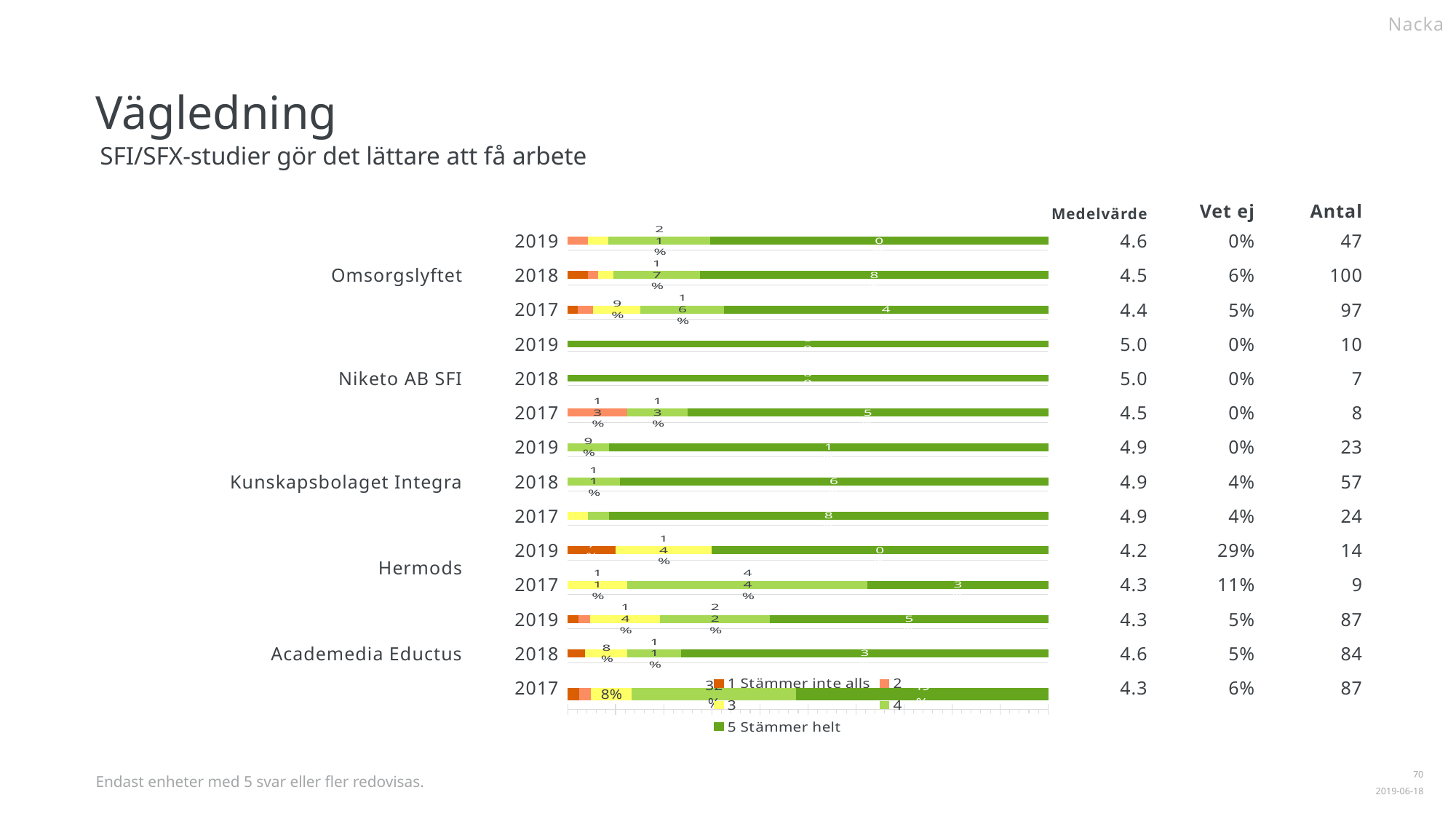
For Hermods, which year has the larger '5 Stämmer helt' segment, 2017 or 2019? 2019 How many bars (year rows) are plotted in the chart? 14 What is the Vet ej value shown for Hermods 2019? 29% How many series does the chart legend list? 5 Which row has the lowest Medelvärde on the slide? Hermods 2019 What type of chart is shown on the slide? bar chart What is the Antal shown for Omsorgslyftet 2018? 100 What is the Medelvärde shown for Omsorgslyftet 2019? 4.6 What is the highest Medelvärde shown on the slide? 5.0 What is the last entry in the chart legend? 5 Stämmer helt What is the first entry in the chart legend? 1 Stämmer inte alls What is the difference in Antal between Omsorgslyftet 2018 and Omsorgslyftet 2019? 53